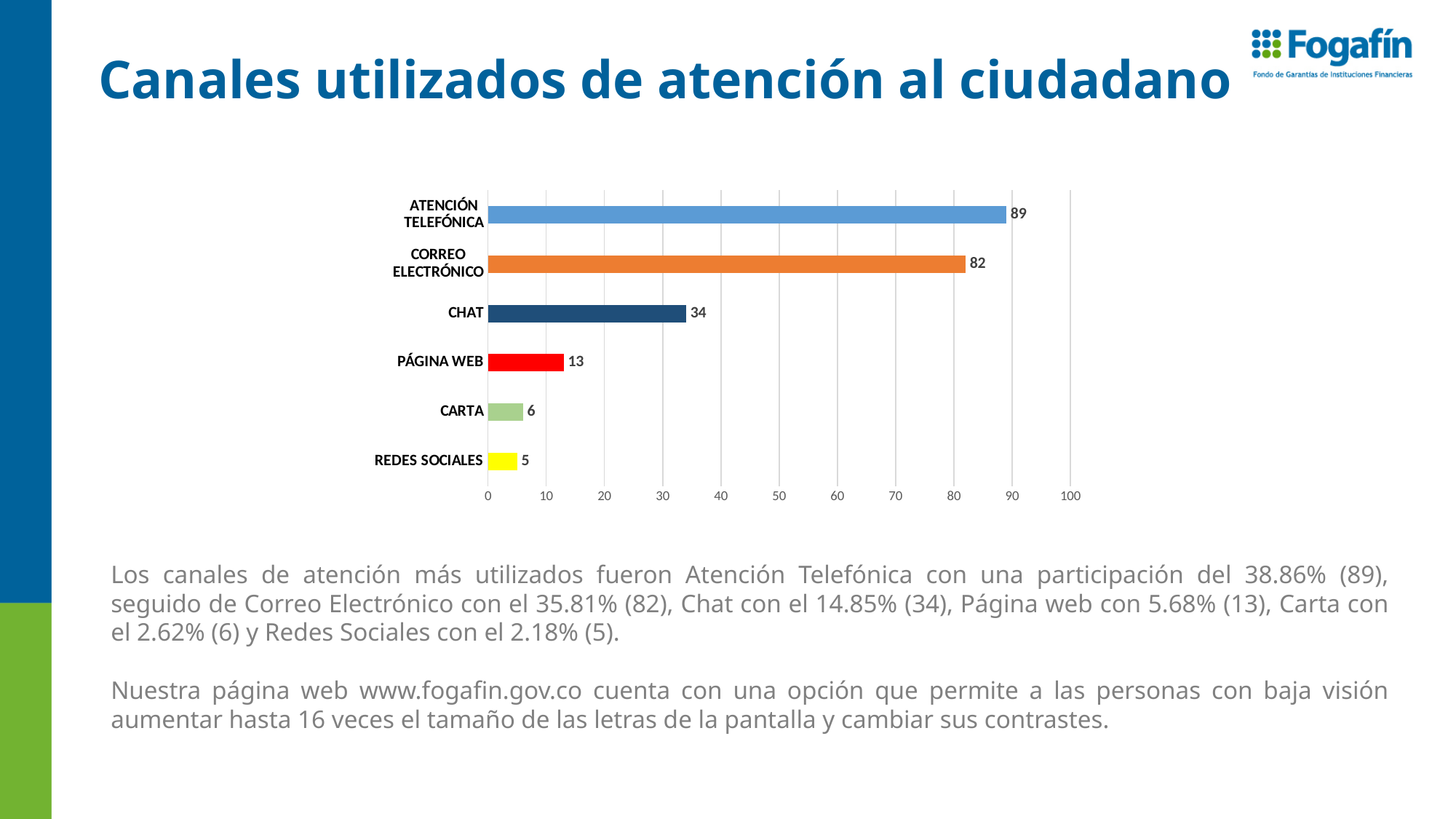
What is the difference between the values for CHAT and PÁGINA WEB? 21 What is the value for PÁGINA WEB? 13 Which is larger, the value for CARTA or the value for REDES SOCIALES? CARTA What kind of chart is shown on the slide? bar chart Which category has the highest value? ATENCIÓN TELEFÓNICA What is the value for CORREO ELECTRÓNICO? 82 Which category has the lowest value? REDES SOCIALES What is the value for CHAT? 34 What is the difference between the values for ATENCIÓN TELEFÓNICA and CORREO ELECTRÓNICO? 7 What is the value for ATENCIÓN TELEFÓNICA? 89 How many categories are shown in the chart? 6 Is the value for CHAT greater or less than 40? less